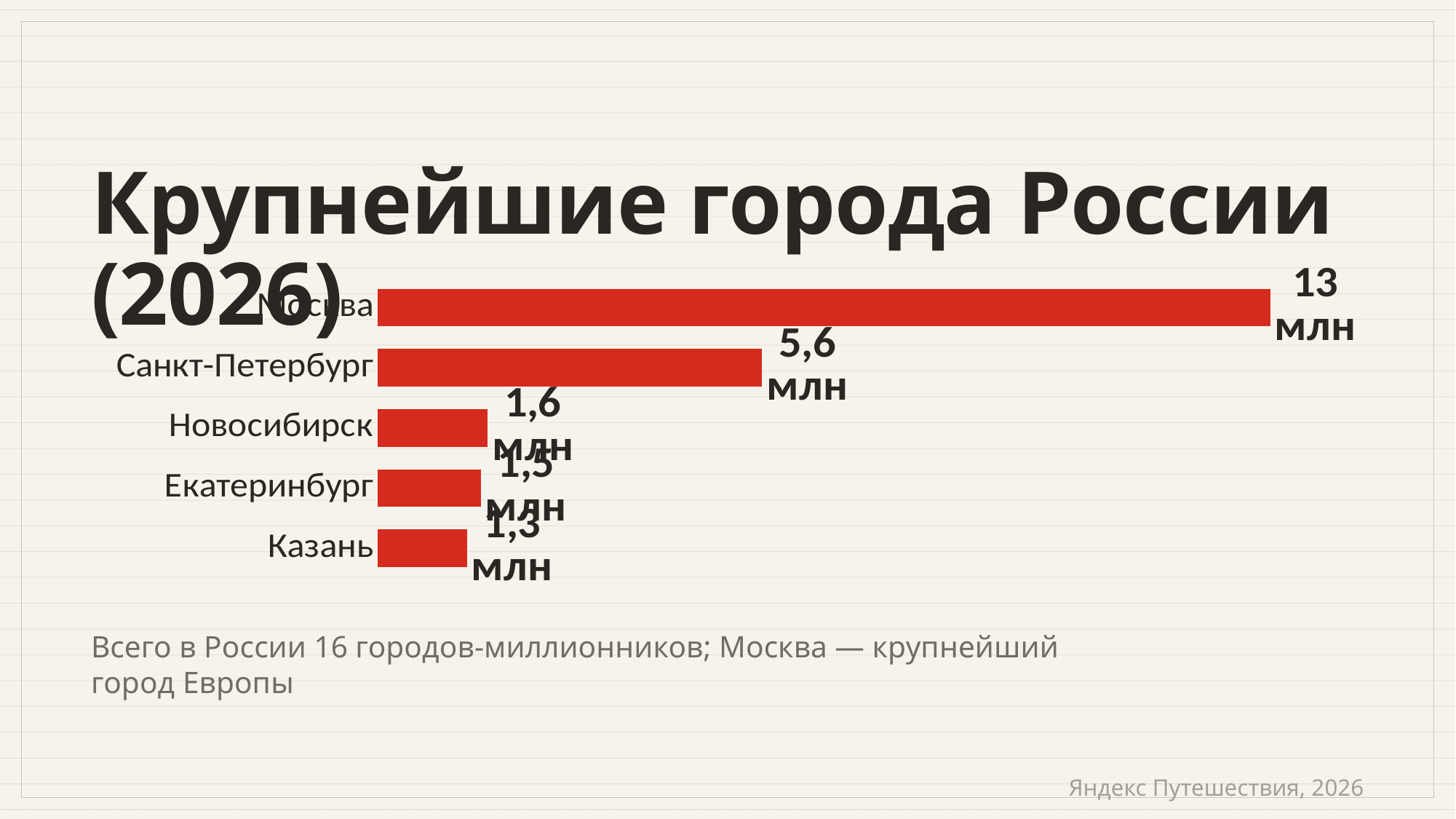
What is the difference between the values for Санкт-Петербург and Новосибирск? 4 млн What is the value shown for Новосибирск? 1,6 млн What is the title of the slide? Крупнейшие города России (2026) What kind of chart is shown on the slide? Bar chart Which is larger, the value for Санкт-Петербург or the value for Новосибирск? Санкт-Петербург How many cities are shown in the chart? 5 What is the value shown for Казань? 1,3 млн What is the value shown for Екатеринбург? 1,5 млн What is the value shown for Санкт-Петербург? 5,6 млн What is the difference between the values for Москва and Санкт-Петербург? 7,4 млн Which city has the highest value in the chart? Москва Which city has the lowest value in the chart? Казань